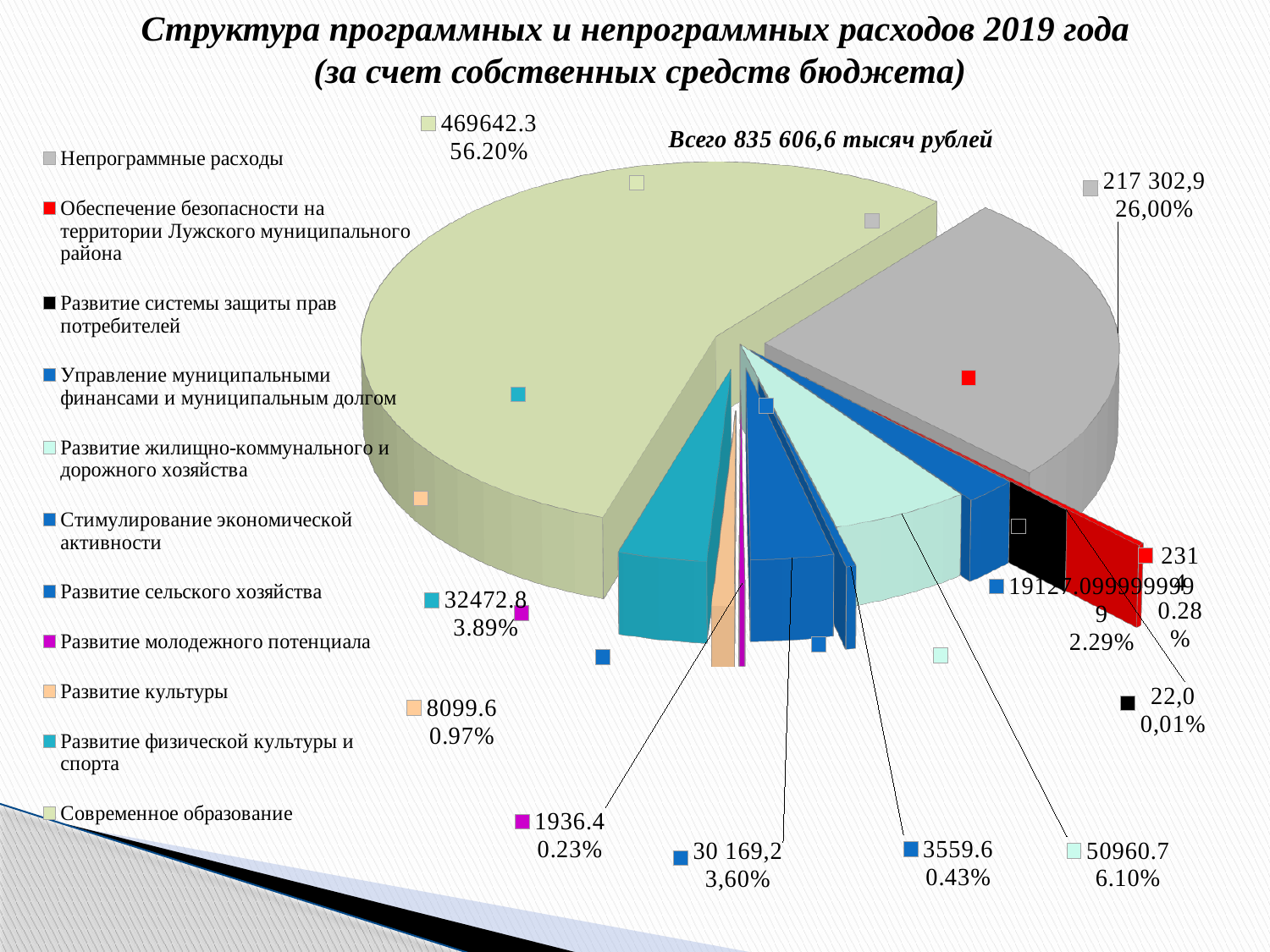
What is the value shown for Непрограммные расходы? 217 302,9 What percentage is shown for Непрограммные расходы? 26,00% What is the value shown for Развитие жилищно-коммунального и дорожного хозяйства? 50960.7 What kind of chart is shown on the slide? pie chart Which category has the largest slice of the pie chart? Современное образование What is the value shown for Развитие культуры? 8099.6 What share of the pie does Современное образование account for? 56.20% What total amount is stated above the pie chart? 835 606,6 тысяч рублей What is the value shown for Развитие физической культуры и спорта? 32472.8 What percentage is shown for Развитие молодежного потенциала? 0.23% How many categories does the legend of the pie chart list? 11 Which category has the smallest slice of the pie chart? Развитие системы защиты прав потребителей